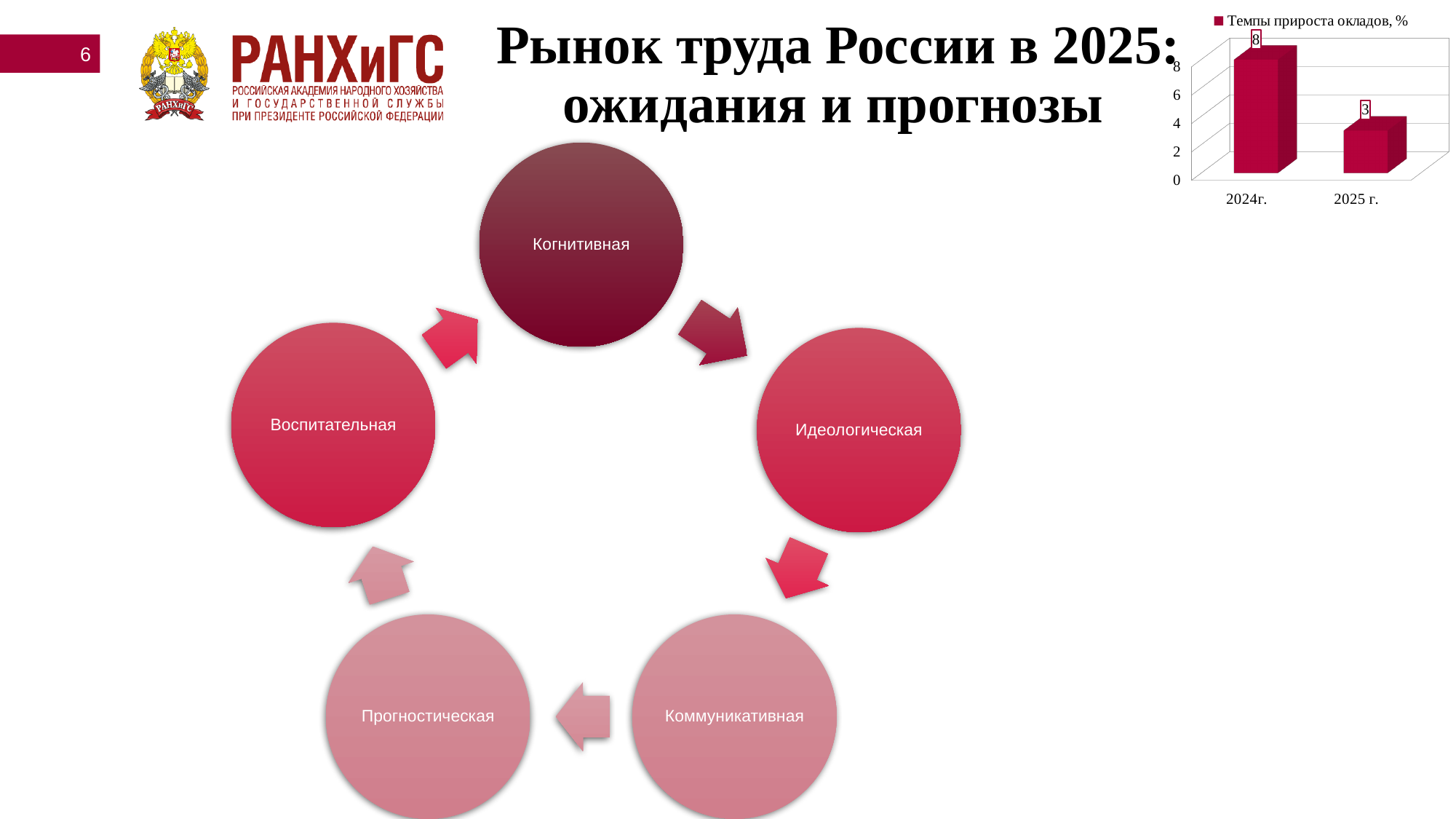
Is the value for 2024г. larger or smaller than the value for 2025 г.? larger What is the series name shown in the legend of the bar chart? Темпы прироста окладов, % Is the value for 2025 г. greater or less than 4? less Which year has the higher value in the bar chart? 2024г. What kind of chart is shown in the top right of the slide? bar chart What is the difference between the values for 2024г. and 2025 г. in the bar chart? 5 Which year has the lowest value in the bar chart? 2025 г. What is the value for 2024г. in the bar chart? 8 How many categories are shown on the x axis of the bar chart? 2 Do the values in the bar chart rise or fall from 2024г. to 2025 г.? fall How many series does the legend of the bar chart list? 1 What is the value for 2025 г. in the bar chart? 3